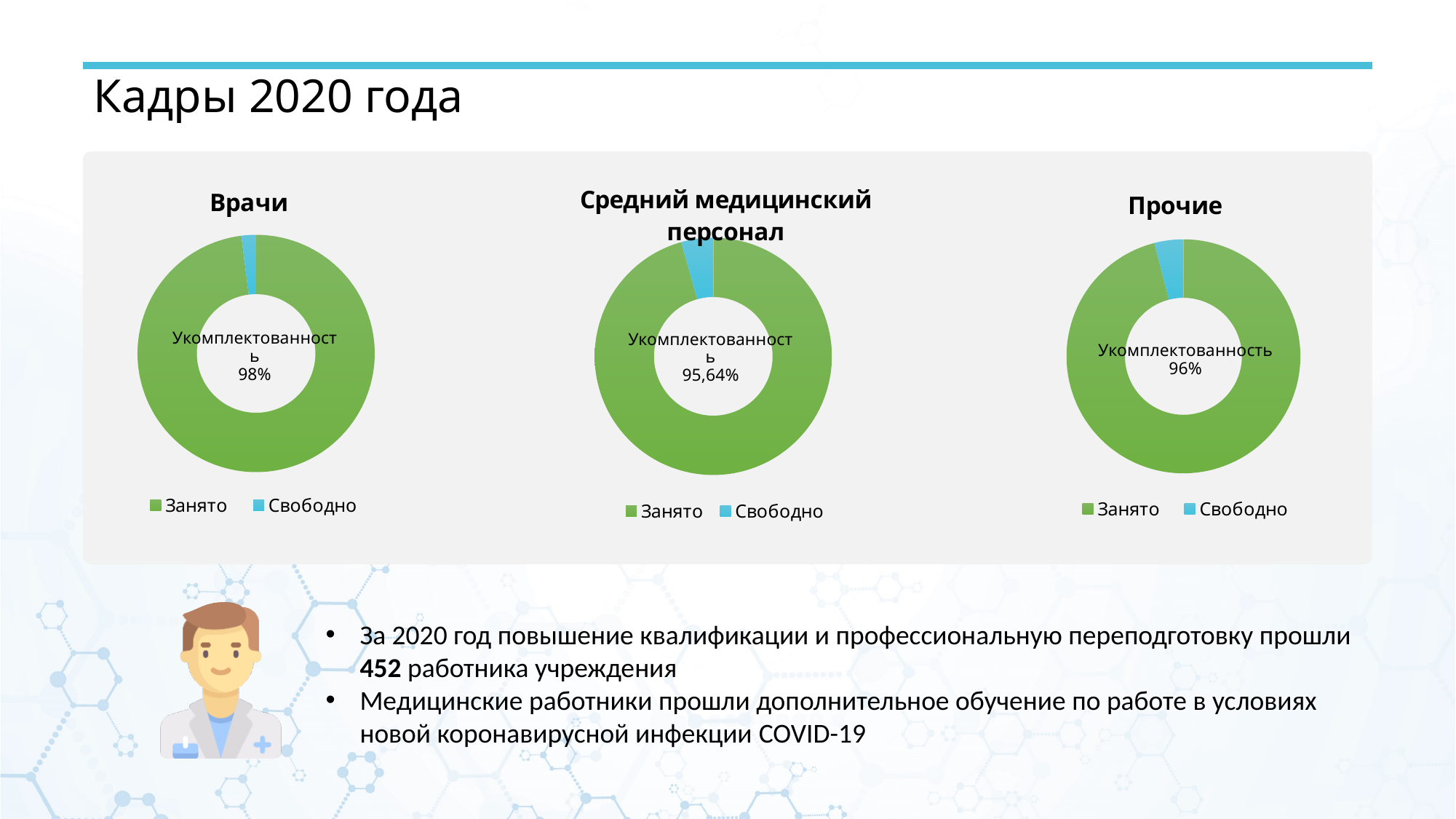
What is the difference between the staffing levels shown in the 'Врачи' chart and the 'Прочие' chart? 2% How many categories does the legend of the 'Средний медицинский персонал' chart list? 2 Is the staffing level higher in the 'Прочие' chart or in the 'Средний медицинский персонал' chart? Прочие Which of the three charts shows the highest staffing level (Укомплектованность)? Врачи In the 'Врачи' chart, which slice is larger, 'Занято' or 'Свободно'? Занято What are the two legend entries in the 'Врачи' chart? Занято, Свободно In the 'Прочие' chart, what colour represents 'Свободно'? Blue In the 'Врачи' chart, what staffing level (Укомплектованность) is shown in the centre? 98% Which of the three charts shows the lowest staffing level (Укомплектованность)? Средний медицинский персонал In the 'Прочие' chart, what staffing level (Укомплектованность) is shown in the centre? 96% In the 'Средний медицинский персонал' chart, what staffing level (Укомплектованность) is shown in the centre? 95,64% What type of chart is the 'Прочие' chart? Doughnut (pie) chart